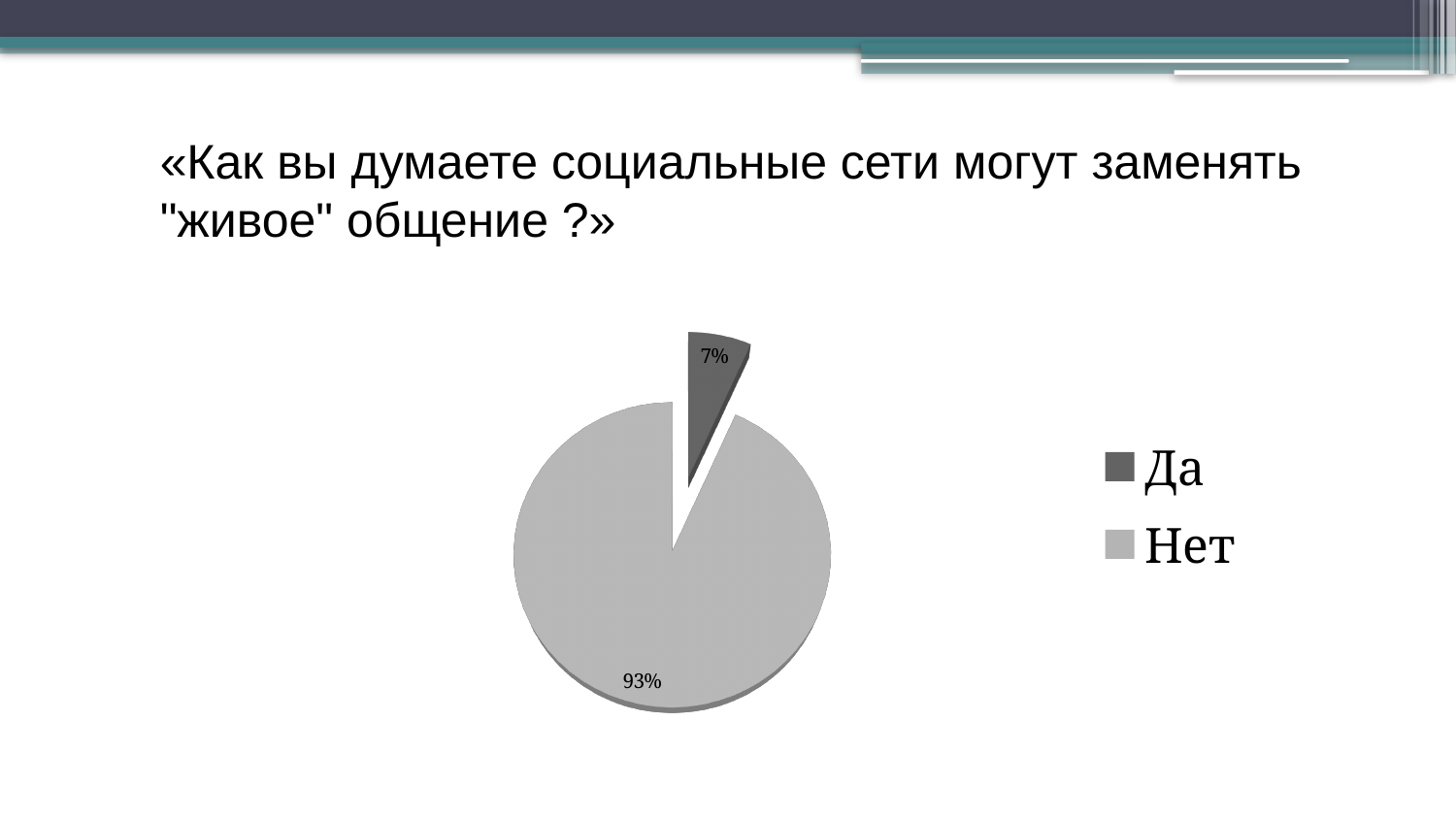
What share of the pie does "Нет" represent? 93% Which category has the largest slice of the pie? Нет What share of the pie does "Да" represent? 7% What is the difference in percentage points between "Нет" and "Да"? 86 How many entries does the legend list? 2 How many categories does the pie chart have? 2 What kind of chart is shown on the slide? pie chart Which slice is pulled out (exploded) from the pie? Да Which legend entry is shown in the lighter grey colour? Нет Which is larger, the share for "Да" or the share for "Нет"? Нет Which category has the smallest slice of the pie? Да